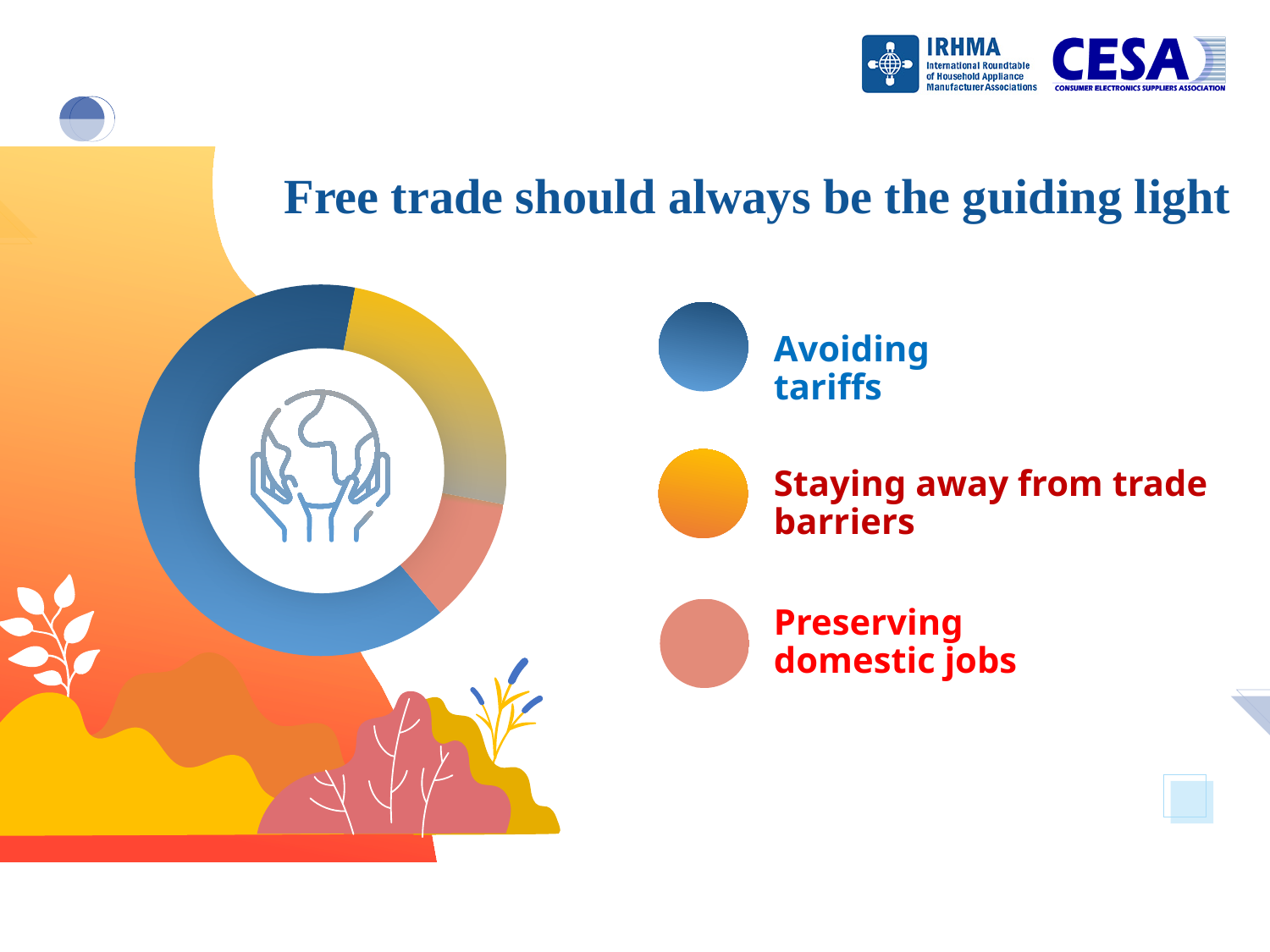
How many categories are listed in the legend next to the donut chart? 3 What kind of chart is shown on the slide? Donut (pie) chart Which segment is larger: Avoiding tariffs or Preserving domestic jobs? Avoiding tariffs What is the title of the slide containing the donut chart? Free trade should always be the guiding light How many segments does the donut chart have? 3 What colour represents Avoiding tariffs in the donut chart? Blue Which category takes up the largest share of the donut chart? Avoiding tariffs Does the Avoiding tariffs segment cover more or less than half of the donut chart? more Which segment is larger: Avoiding tariffs or Staying away from trade barriers? Avoiding tariffs